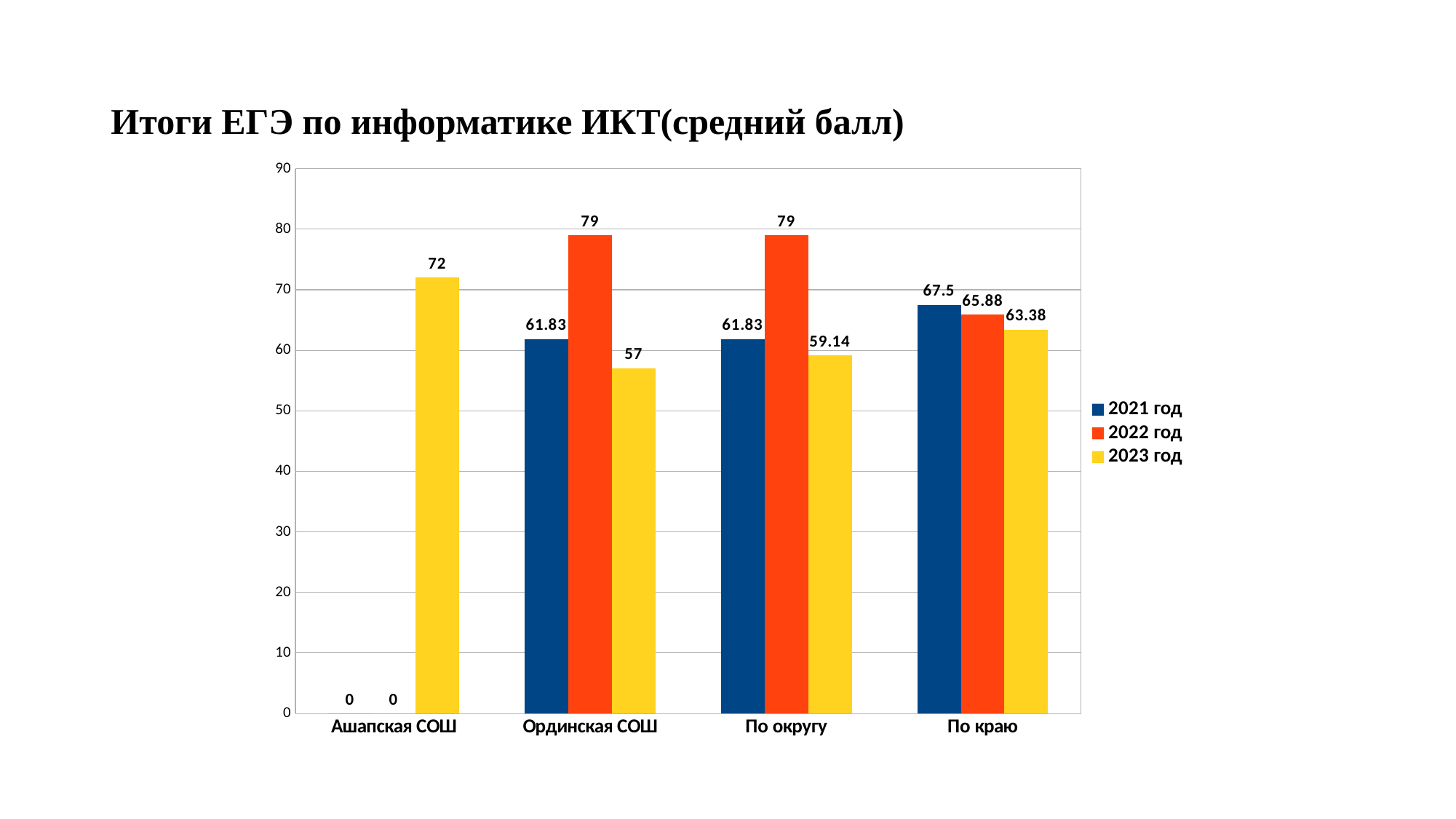
What is the value for Ординская СОШ in the 2022 год series? 79 What kind of chart is shown on the slide? Bar chart What is the difference between the 2022 год and 2023 год values for Ординская СОШ? 22 How many categories are shown on the x axis? 4 What is the value for По краю in the 2021 год series? 67.5 Which category has the lowest value in the 2023 год series? Ординская СОШ What is the value for По округу in the 2023 год series? 59.14 How many series does the legend list? 3 Which category has the highest value in the 2021 год series? По краю What is the value for Ашапская СОШ in the 2023 год series? 72 Which is larger for По краю: the 2022 год value or the 2023 год value? 2022 год What is the title of the chart? Итоги ЕГЭ по информатике ИКТ(средний балл)